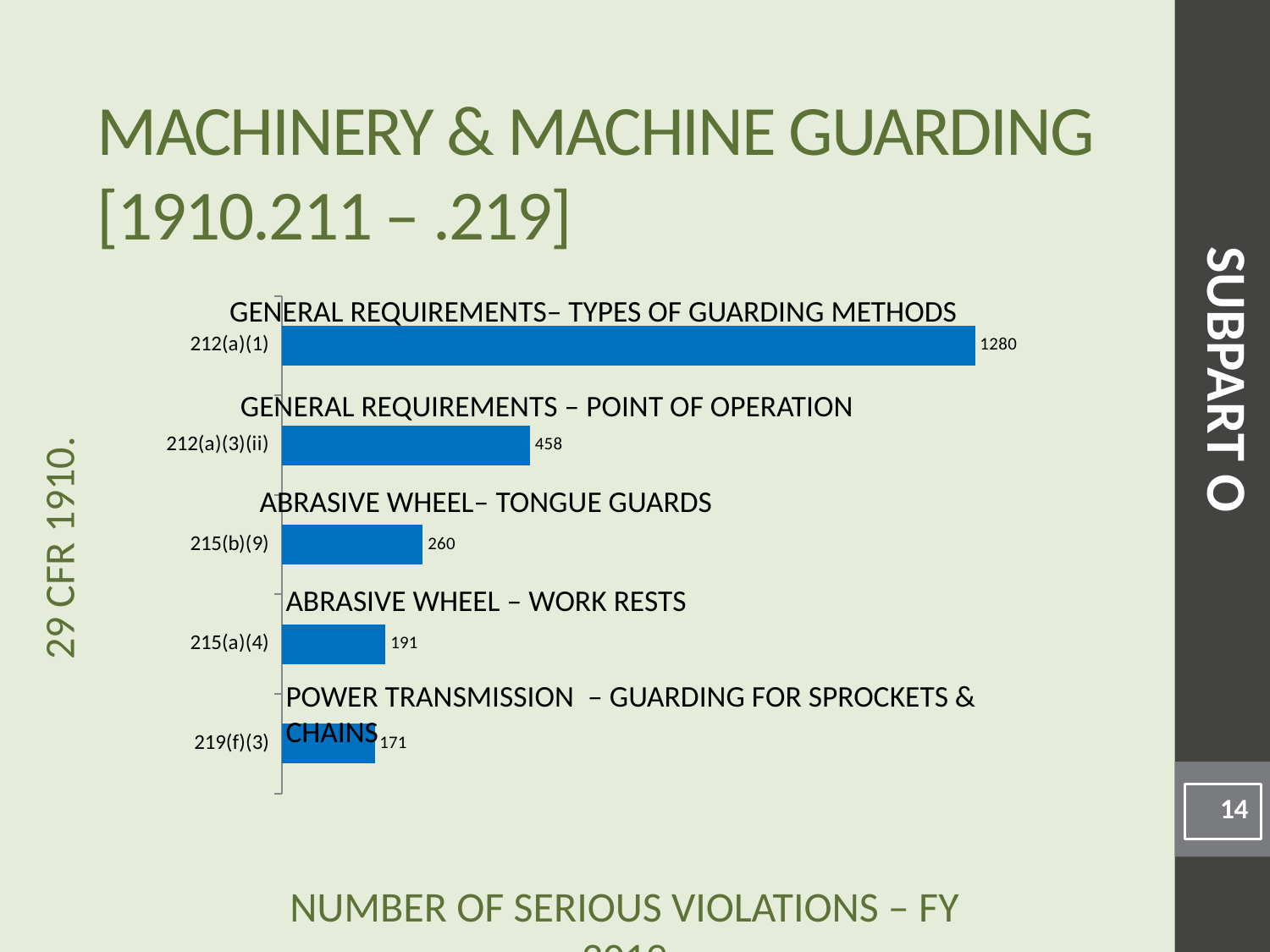
What is the number of serious violations for 219(f)(3)? 171 What is the difference in serious violations between 215(b)(9) and 215(a)(4)? 69 Which standard has the highest number of serious violations? 212(a)(1) What is the number of serious violations for 212(a)(1)? 1280 What is the difference in serious violations between 212(a)(1) and 212(a)(3)(ii)? 822 What is the number of serious violations for 215(b)(9)? 260 What kind of chart is shown on the slide? Bar chart What is the number of serious violations for 212(a)(3)(ii)? 458 Which has more serious violations, 215(a)(4) or 219(f)(3)? 215(a)(4) How many standards are shown in the chart? 5 Which standard has the lowest number of serious violations? 219(f)(3) What is the number of serious violations for 215(a)(4)? 191